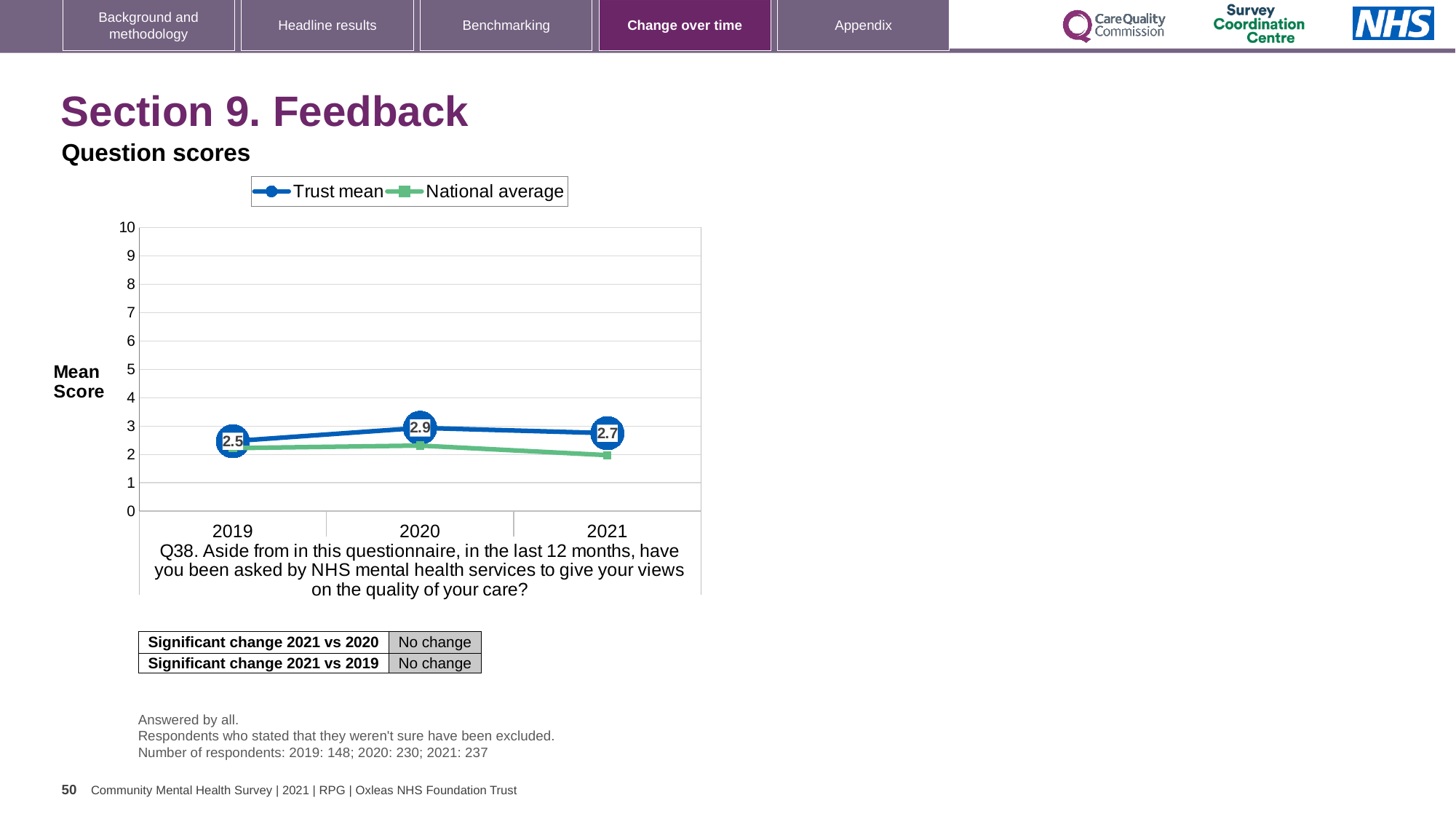
What is the difference between the Trust mean scores for 2020 and 2019? 0.4 How many years are plotted on the x axis? 3 What kind of chart is shown on the slide? line chart What is the Trust mean score for 2021? 2.7 How many series does the legend list? 2 What is the Trust mean score for 2019? 2.5 In which year is the Trust mean score lowest? 2019 What is the Trust mean score for 2020? 2.9 Is the National average value for 2020 greater or less than 3? less In which year is the Trust mean score highest? 2020 Which is larger in 2021, the Trust mean or the National average? Trust mean Does the Trust mean rise or fall from 2020 to 2021? fall